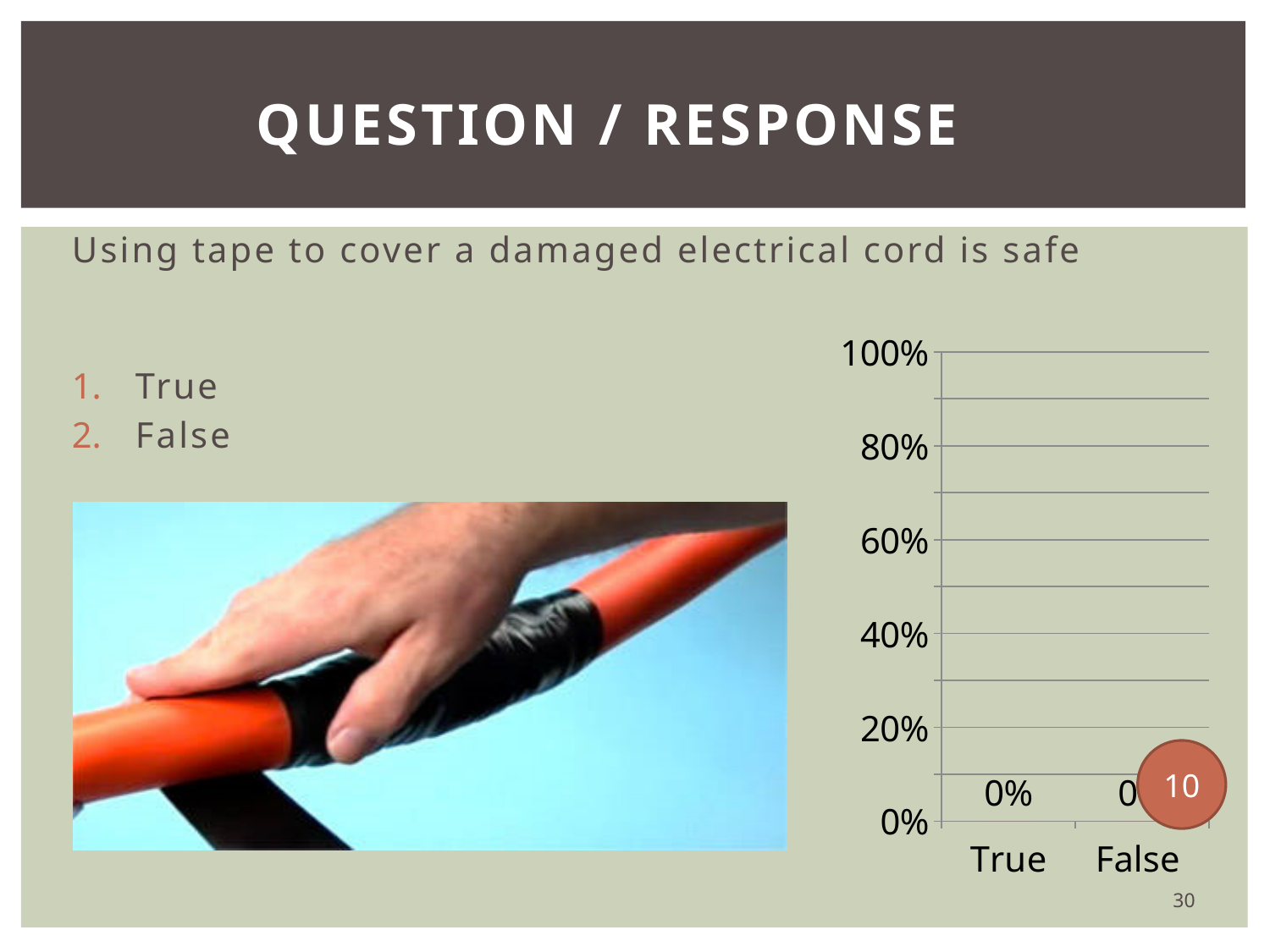
Is the value for True greater or less than 40%? less What kind of chart is shown on the slide? bar chart How many categories are shown on the x axis of the chart? 2 What is the value shown for True in the chart? 0% What are the category labels on the x axis of the chart? True, False Is the value for False greater or less than 20%? less What is the highest value labelled on the y axis of the chart? 100%